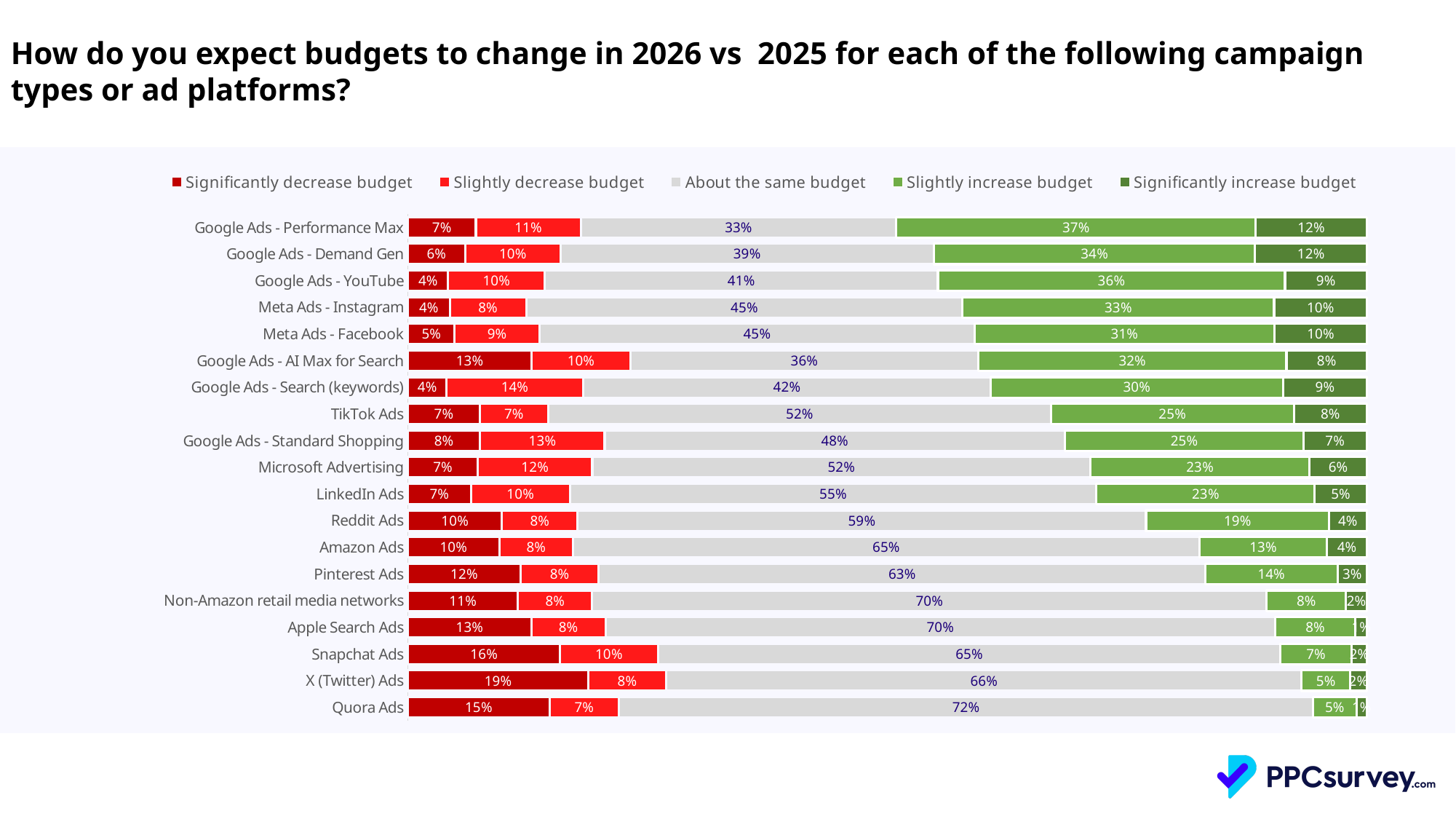
How many campaign types or ad platforms are listed in the chart? 19 Which has a larger 'Significantly increase budget' share: Meta Ads - Instagram or Microsoft Advertising? Meta Ads - Instagram What is the 'About the same budget' value for Quora Ads? 72% What kind of chart is shown on the slide? Stacked bar chart What percentage of respondents expect to slightly increase budget for Google Ads - Performance Max? 37% Which campaign type or platform has the highest 'Significantly decrease budget' share? X (Twitter) Ads Which campaign type or platform has the highest 'About the same budget' share? Quora Ads What is the difference between the 'Slightly increase budget' values for Google Ads - YouTube and TikTok Ads? 11% What percentage expect to significantly decrease budget for X (Twitter) Ads? 19% Which campaign type or platform has the highest 'Slightly increase budget' share? Google Ads - Performance Max How many series does the legend list? 5 Which legend entry is shown in light grey? About the same budget